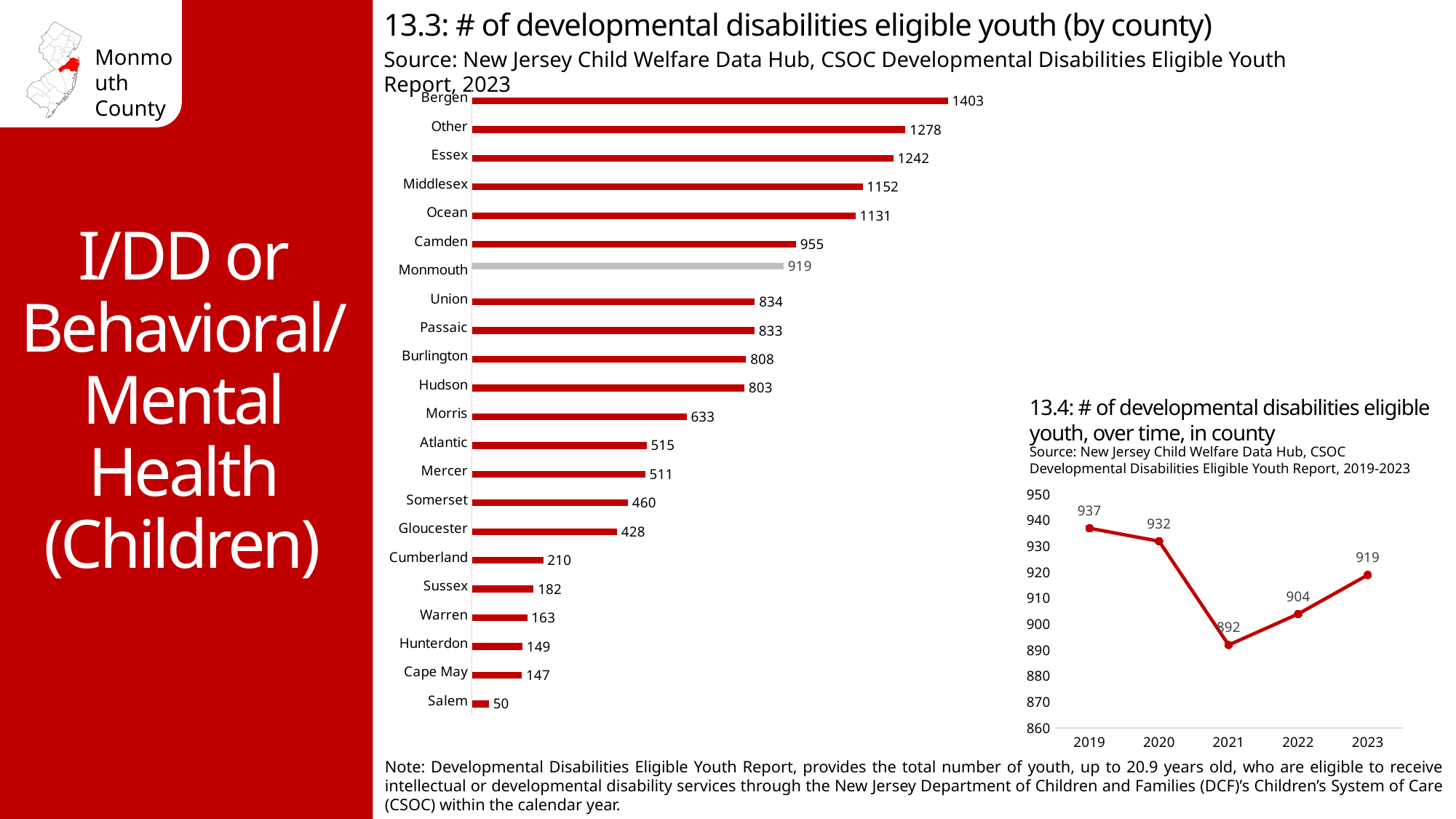
In the line chart 13.4, how many data points are plotted? 5 In the line chart 13.4, what is the value for 2021? 892 What type of chart is chart 13.3? Bar chart In the bar chart 13.3, what is the number of developmental disabilities eligible youth for Monmouth? 919 In the bar chart 13.3, what is the value for Cumberland? 210 In the line chart 13.4, what is the difference between 2023 and 2022? 15 In the bar chart 13.3, which county has the highest number of eligible youth? Bergen In the bar chart 13.3, which has more eligible youth, Camden or Union? Camden In the line chart 13.4, which year has the highest value? 2019 How many categories are shown in the bar chart 13.3? 22 In the bar chart 13.3, what is the difference between Bergen and Essex? 161 In the bar chart 13.3, which county has the lowest number of eligible youth? Salem